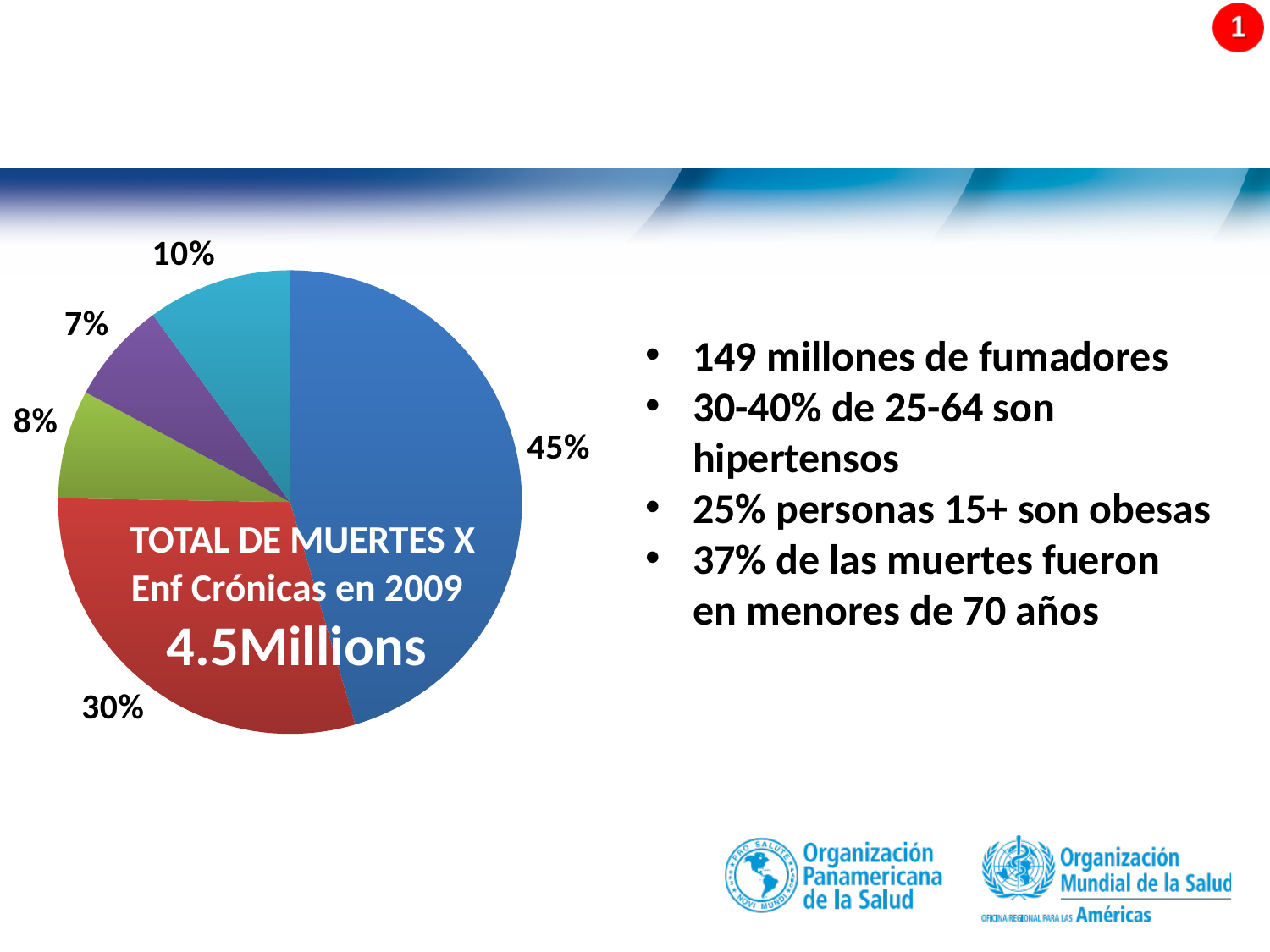
What total number of deaths is written in the centre of the pie chart? 4.5Millions What percentage is labelled on the red slice of the pie chart? 30% Which slice is larger, the one labelled 8% or the one labelled 10%? 10% What is the largest percentage shown on the pie chart? 45% How many slices does the pie chart have? 5 What is the smallest percentage shown on the pie chart? 7% What percentage is labelled on the purple slice of the pie chart? 7% What percentage is labelled on the teal slice of the pie chart? 10% What percentage is labelled on the blue slice of the pie chart? 45% What kind of chart is shown on the slide? pie chart What is the difference in percentage points between the largest slice (45%) and the second largest slice (30%)? 15 percentage points What percentage is labelled on the green slice of the pie chart? 8%